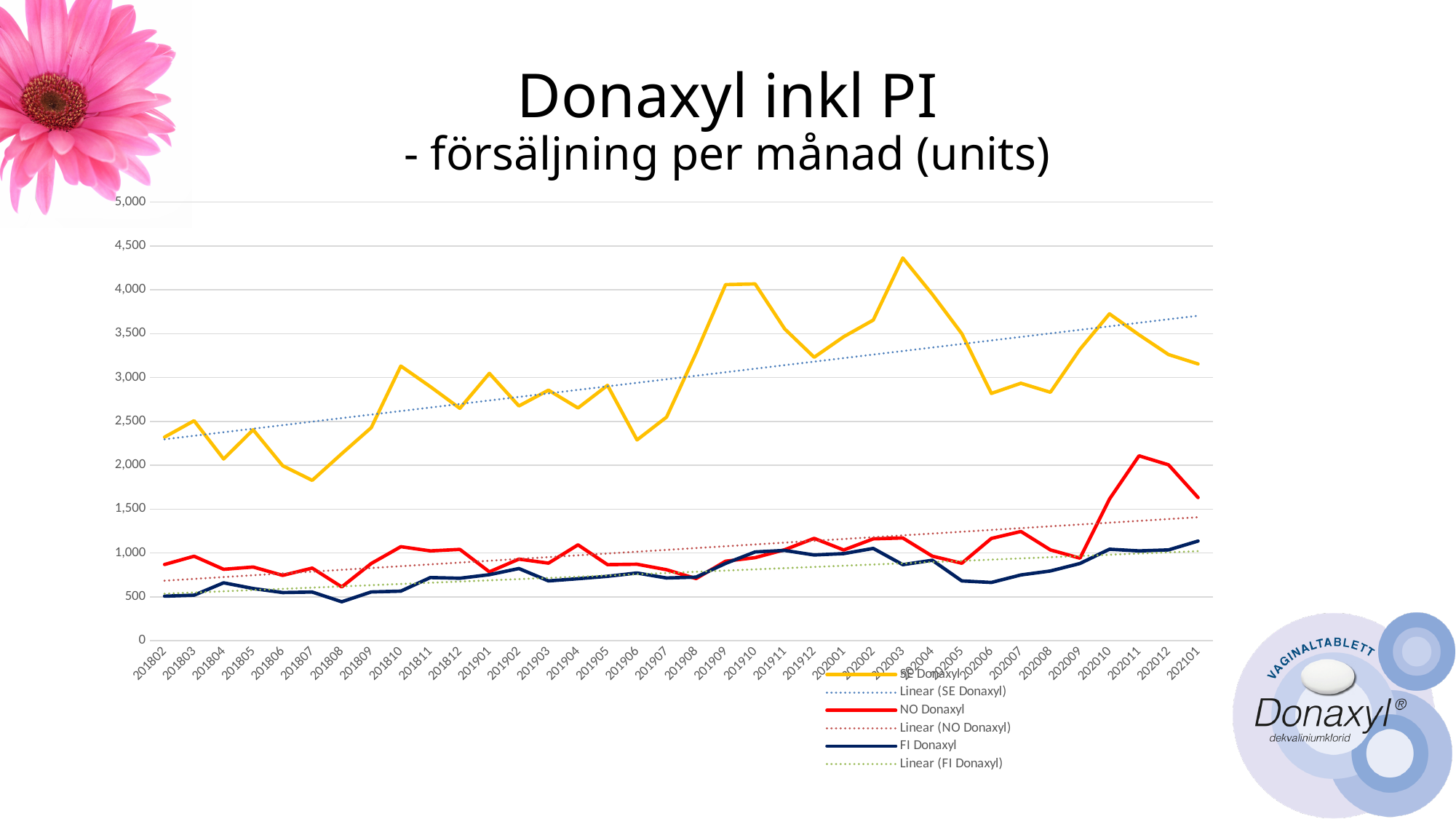
Is the value for SE Donaxyl in 201807 greater or less than 2,000? less How many months are plotted along the x axis? 36 What colour is the SE Donaxyl line? yellow Is the value for SE Donaxyl in 202003 greater or less than 4,000? greater Is the value for FI Donaxyl in 201808 greater or less than 500? less Does the Linear (SE Donaxyl) trendline rise or fall from left to right? rise In 202011, which is larger: NO Donaxyl or FI Donaxyl? NO Donaxyl In which month does SE Donaxyl reach its highest value? 202003 What kind of chart is shown on the slide? line chart Which series has the highest values across the whole period? SE Donaxyl How many entries does the chart legend list? 6